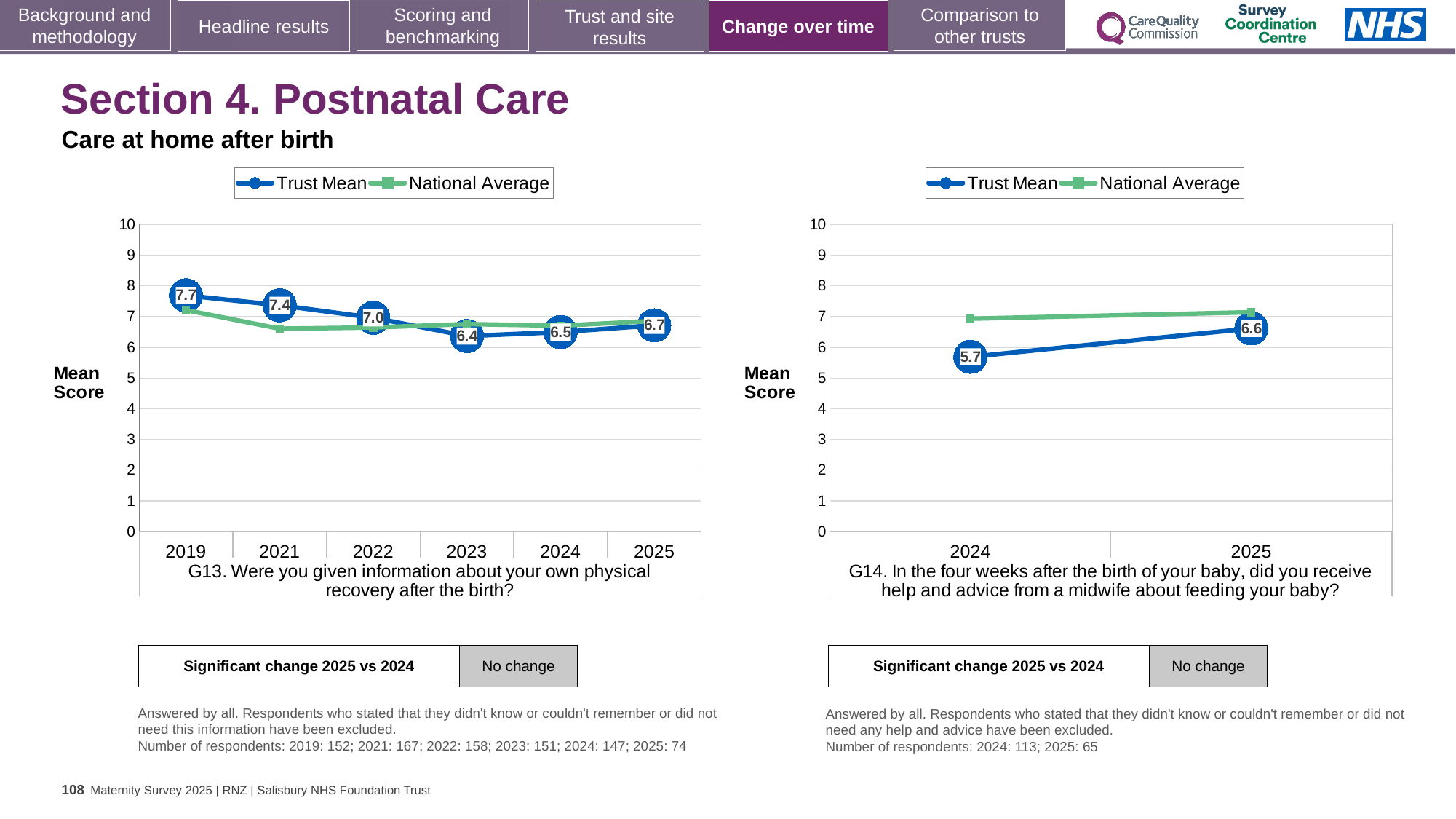
In the G13 chart (left), which year has the lowest Trust Mean score? 2023 What type of chart is used for G13 (left)? Line chart How many series does the legend of the G14 chart (right) list? 2 In the G14 chart (right), what is the difference between the Trust Mean scores for 2025 and 2024? 0.9 In the G13 chart (left), which year has the highest Trust Mean score? 2019 In the G13 chart (left), is the National Average for 2021 greater or less than 7? less In the G13 chart (left), what is the Trust Mean score for 2019? 7.7 In the G14 chart (right), what is the Trust Mean score for 2024? 5.7 In the G13 chart (left), what is the difference between the Trust Mean scores for 2019 and 2025? 1.0 In the G13 chart (left), what is the Trust Mean score for 2023? 6.4 In the G14 chart (right), is the Trust Mean or the National Average higher in 2024? National Average How many years are plotted on the x axis of the G13 chart (left)? 6